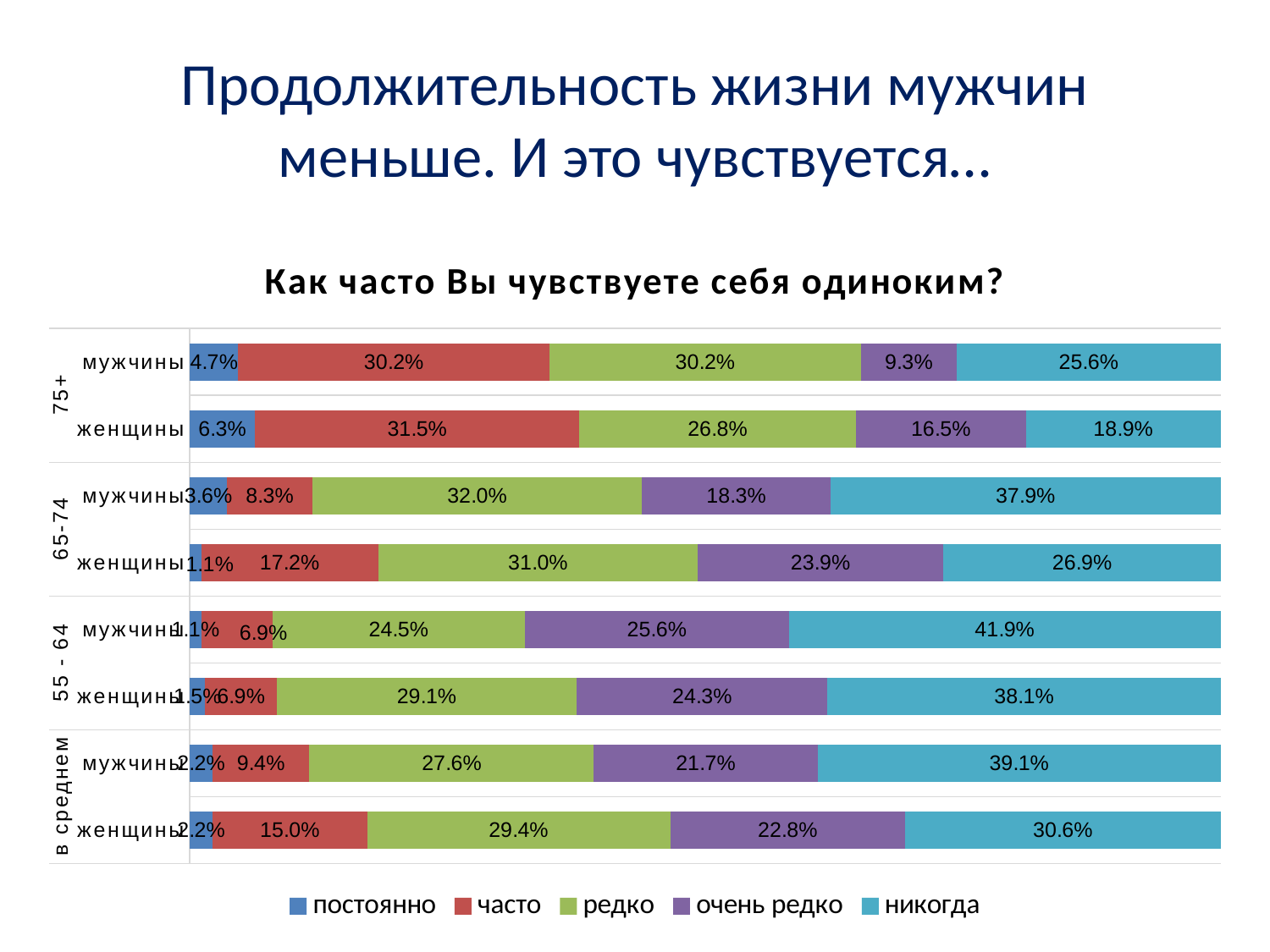
What is the "часто" value for women aged 75+? 31.5% What is the "часто" value for women in the "в среднем" group? 15.0% What percentage of men aged 65-74 answered "никогда"? 37.9% What is the "очень редко" value for women aged 65-74? 23.9% How many series does the legend list? 5 What kind of chart is shown on the slide? Stacked bar chart Which group has the highest "никогда" value? мужчины 55 - 64 What is the difference between the "никогда" values for men and women in the "в среднем" group? 8.5% What percentage of men aged 75+ answered "никогда"? 25.6% Which group has the lowest "никогда" value? женщины 75+ What is the title of the chart? Как часто Вы чувствуете себя одиноким? Which is larger: the "часто" value for men aged 65-74 or for women aged 65-74? женщины 65-74